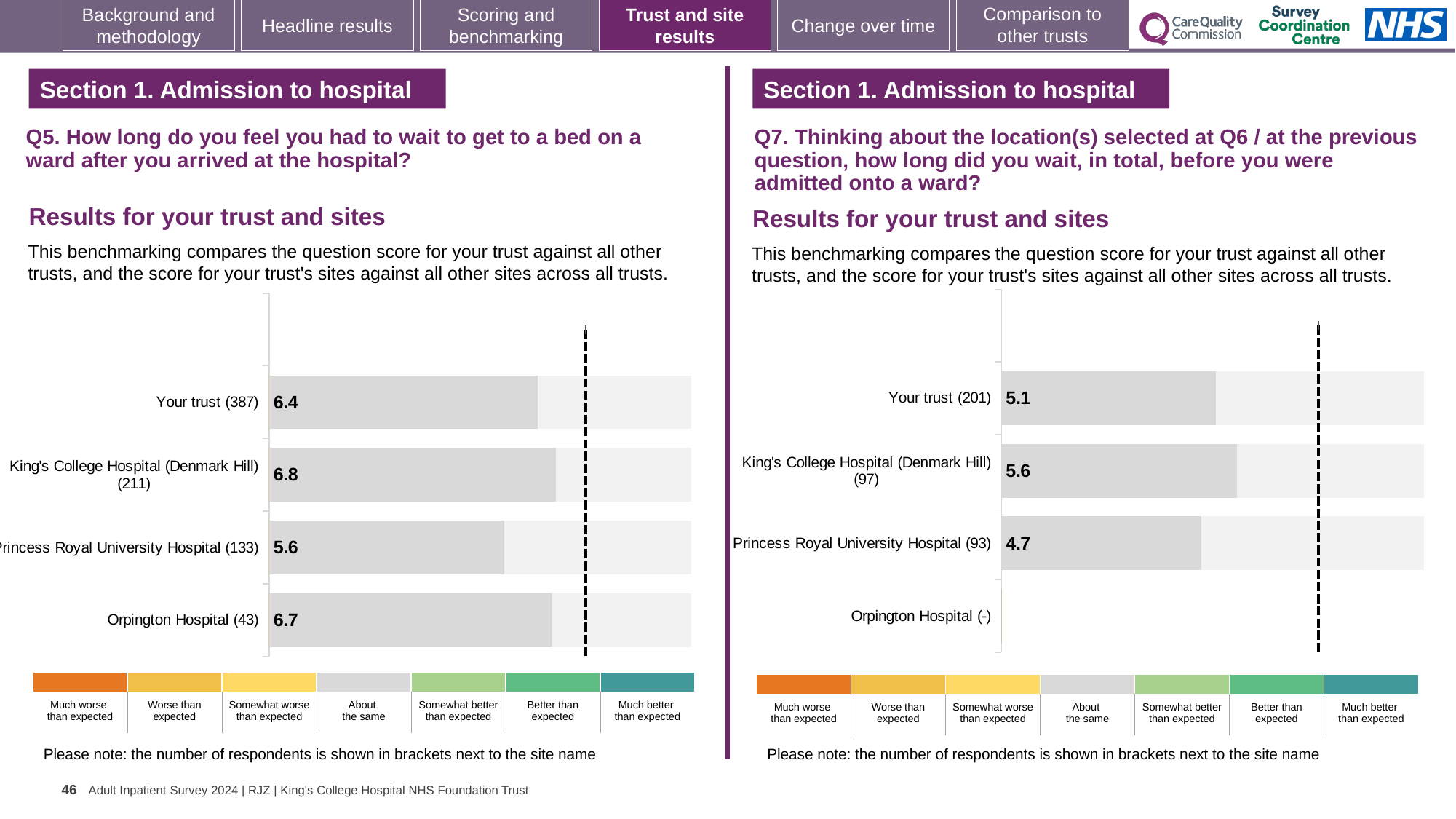
In the Q5 chart on the left, how many respondents are shown for Orpington Hospital? 43 In the Q5 chart on the left, what is the score for Princess Royal University Hospital? 5.6 In the Q7 chart on the right, what is the difference between the scores for King's College Hospital (Denmark Hill) and Princess Royal University Hospital? 0.9 In the Q5 chart on the left, what is the score for Your trust? 6.4 What kind of chart is the Q5 chart on the left? Bar chart In the Q5 chart on the left, which site or trust has the highest score? King's College Hospital (Denmark Hill) In the Q7 chart on the right, is the score for Your trust or for King's College Hospital (Denmark Hill) larger? King's College Hospital (Denmark Hill) In the Q7 chart on the right, which site or trust has the lowest score shown? Princess Royal University Hospital In the Q7 chart on the right, what is the score for Your trust? 5.1 In the Q5 chart on the left, what is the difference between the scores for King's College Hospital (Denmark Hill) and Princess Royal University Hospital? 1.2 In the Q5 chart on the left, which site or trust has the lowest score? Princess Royal University Hospital In the Q7 chart on the right, what is the score for King's College Hospital (Denmark Hill)? 5.6